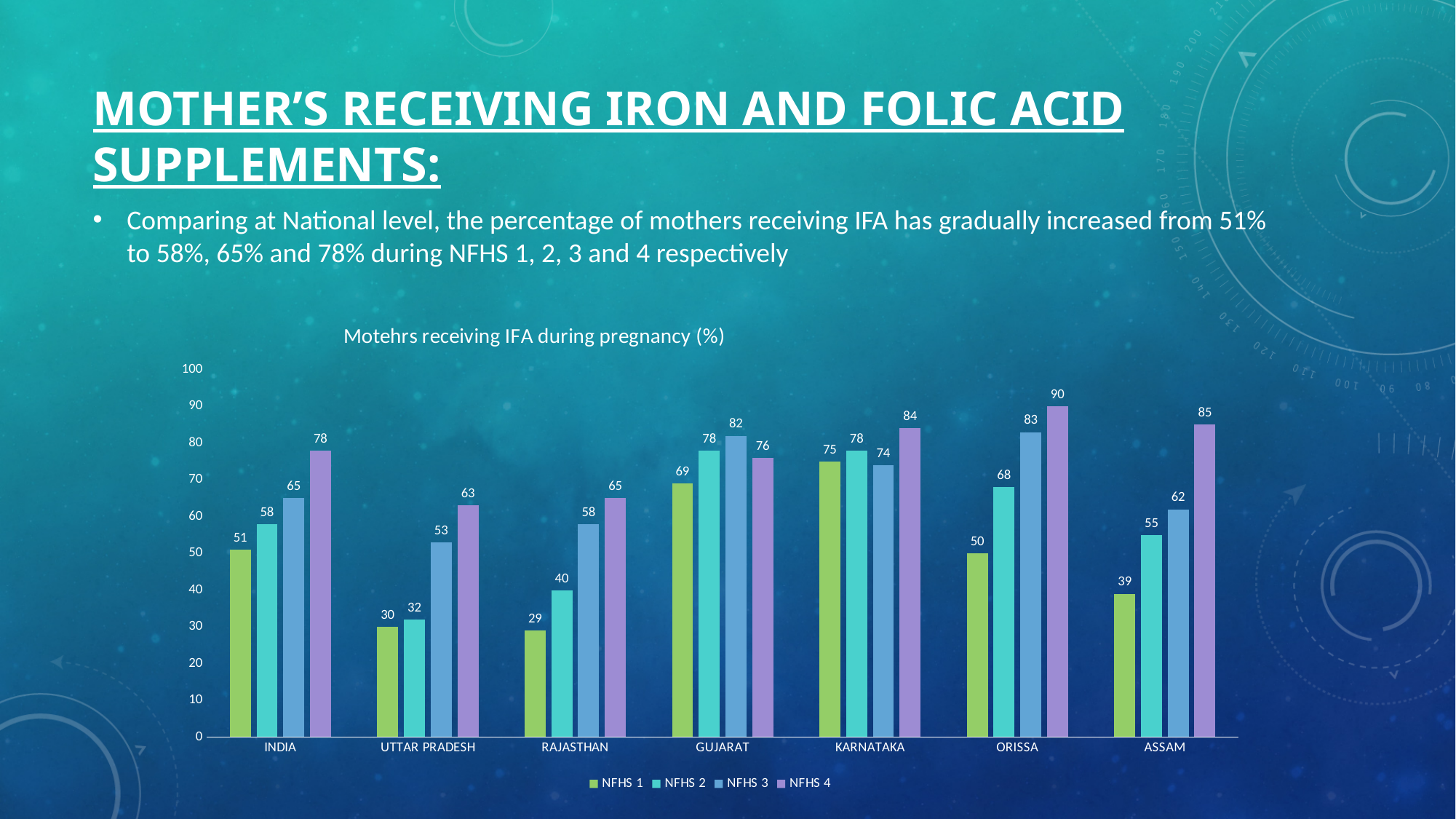
What is the NFHS 1 value for Rajasthan? 29 What is the NFHS 3 value for Gujarat? 82 Which is larger for Karnataka: the NFHS 2 value or the NFHS 3 value? NFHS 2 How many states are shown on the x axis of the chart? 7 Do the values for India rise or fall from NFHS 1 to NFHS 4? Rise What kind of chart is shown on the slide? Bar chart What is the NFHS 4 value for Orissa? 90 Which state has the highest NFHS 4 value? Orissa What is the title of the chart? Motehrs receiving IFA during pregnancy (%) What is the difference between the NFHS 4 and NFHS 1 values for Assam? 46 How many series does the legend list? 4 Which state has the lowest NFHS 2 value? Uttar Pradesh